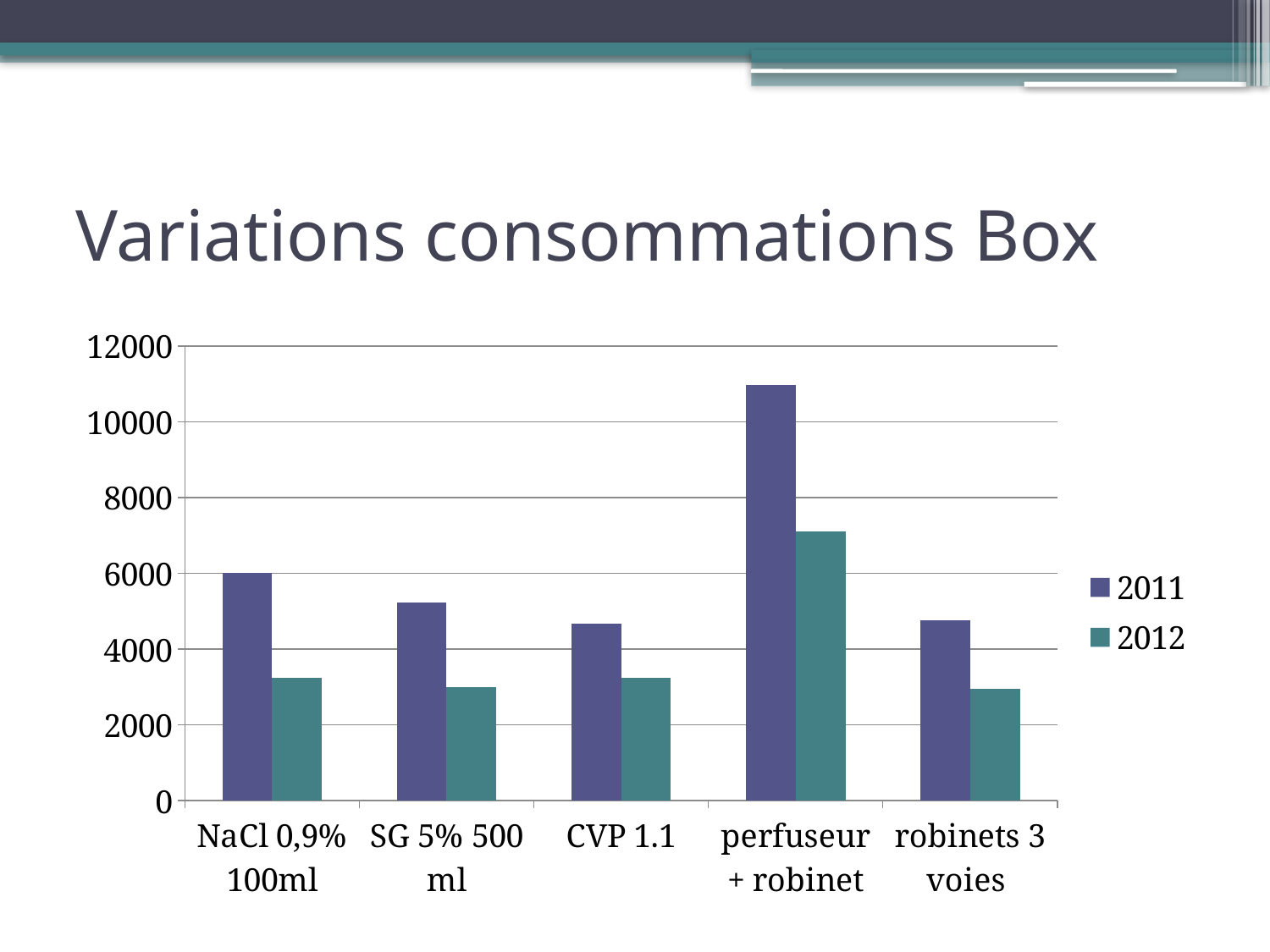
Which category has the highest 2011 value? perfuseur + robinet Is the 2011 value for SG 5% 500 ml greater or less than 4000? greater How many categories are shown on the x axis? 5 What is the title of the slide containing the chart? Variations consommations Box What type of chart is shown on the slide? bar chart Which is larger: the 2011 value for NaCl 0,9% 100ml or the 2011 value for robinets 3 voies? NaCl 0,9% 100ml Which category has the highest 2012 value? perfuseur + robinet Is the 2011 value for perfuseur + robinet greater or less than 10000? greater How many series does the legend list? 2 Is the 2012 value for NaCl 0,9% 100ml greater or less than 4000? less For CVP 1.1, which year has the larger value, 2011 or 2012? 2011